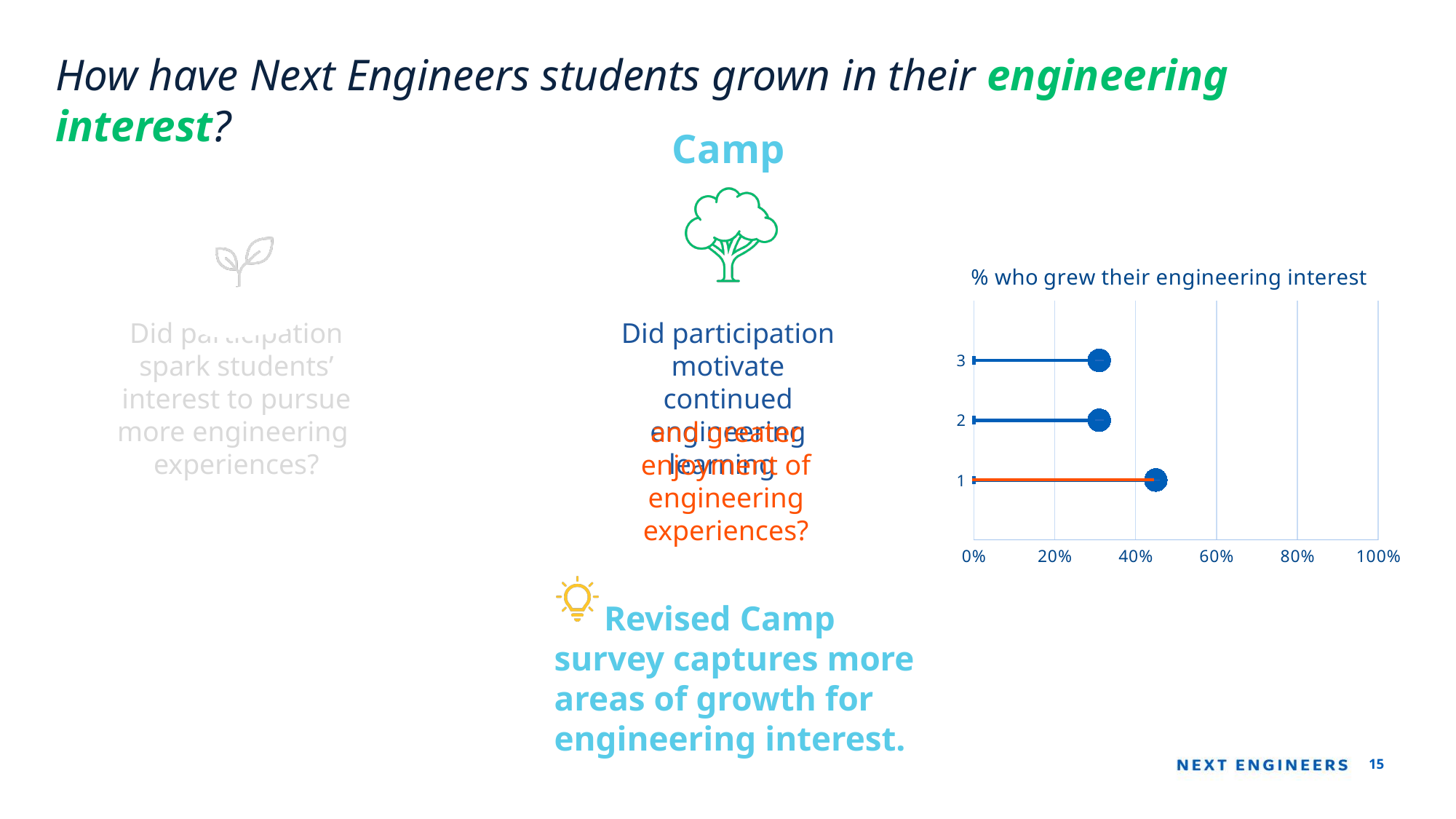
What is the maximum value shown on the x axis of the chart? 100% Is the value for category 1 greater or less than 40%? greater Is the value for category 3 greater or less than 40%? less Is the value for category 1 greater or less than 60%? less Which has a larger value, category 1 or category 3? 1 What is the title of the chart on the slide? % who grew their engineering interest How many categories are plotted in the chart? 3 What kind of chart is shown on the slide? bar chart Which category has the highest value in the chart? 1